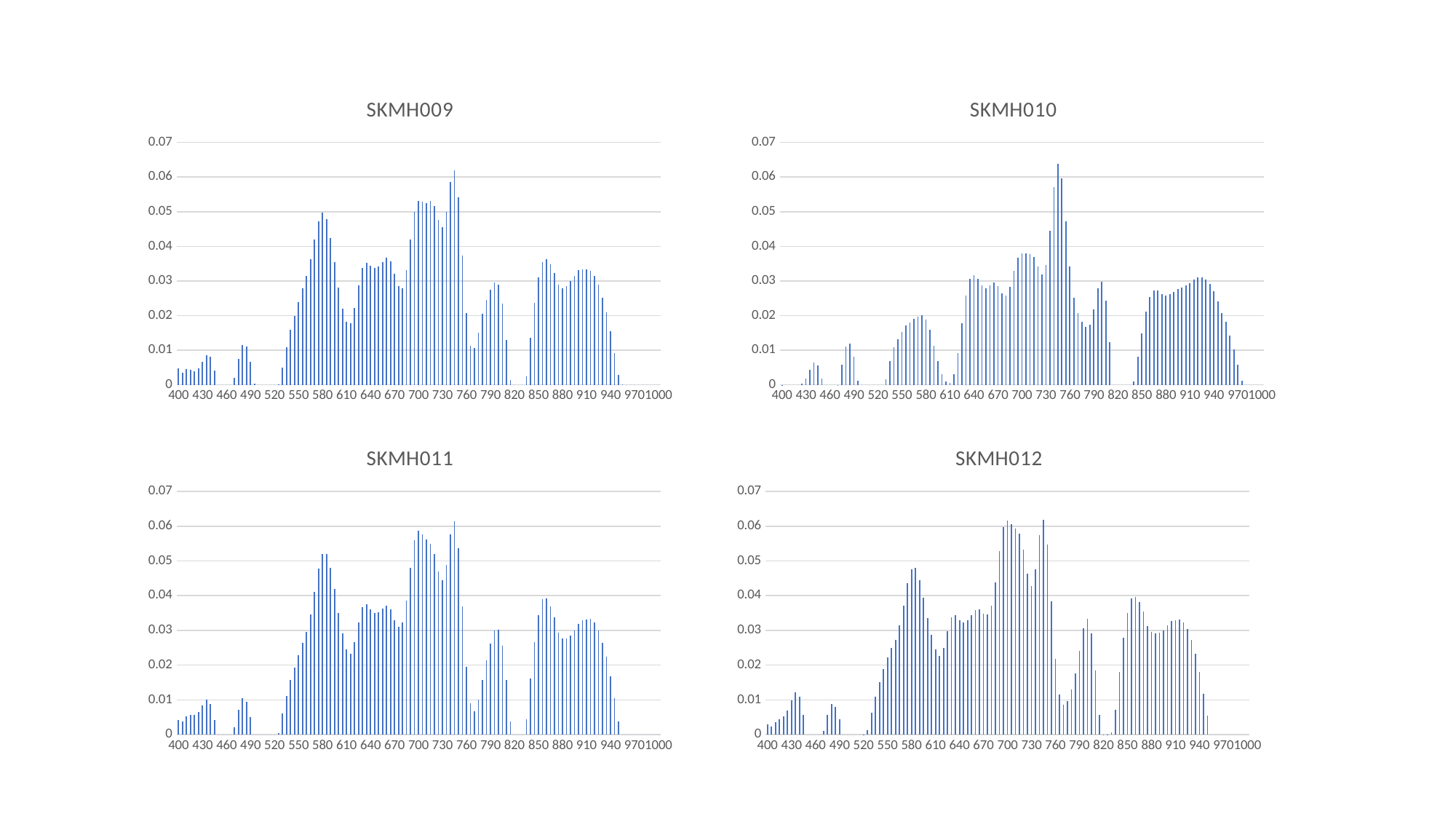
In the SKMH009 chart, is the tallest bar (near 750) greater or less than 0.06? greater In the SKMH009 chart, what is the highest value shown on the vertical axis? 0.07 What kind of chart is SKMH009? bar chart In the SKMH010 chart, is the tallest bar (near 745) greater or less than 0.06? greater In the SKMH010 chart, is the value at 700 greater or less than 0.03? greater What are the titles of the four charts on the slide? SKMH009, SKMH010, SKMH011, SKMH012 In the SKMH012 chart, which is larger, the value at 580 or the value at 850? 580